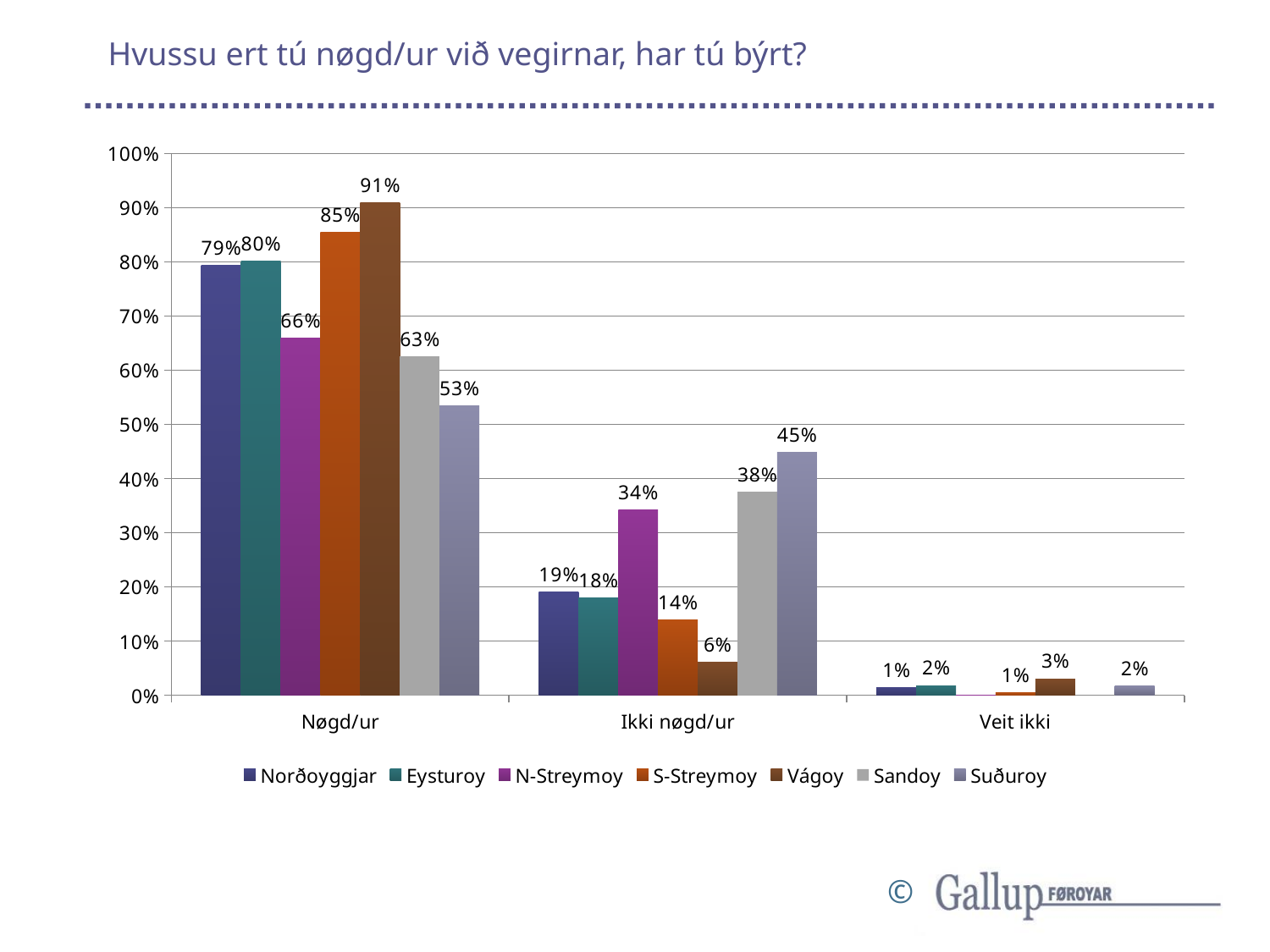
What is the value for Vágoy in the Veit ikki category? 3% What is the value for N-Streymoy in the Nøgd/ur category? 66% Which region has the highest value in the Nøgd/ur category? Vágoy How many series does the legend list? 7 What is the value for Suðuroy in the Ikki nøgd/ur category? 45% What percentage of Vágoy respondents answered Nøgd/ur? 91% What kind of chart is shown on the slide? Bar chart Which region has the lowest value in the Nøgd/ur category? Suðuroy Which is larger in the Ikki nøgd/ur category: N-Streymoy or Sandoy? Sandoy Which region has the lowest value in the Ikki nøgd/ur category? Vágoy How many categories are shown on the x axis? 3 What is the difference between Vágoy and Sandoy in the Nøgd/ur category? 28%